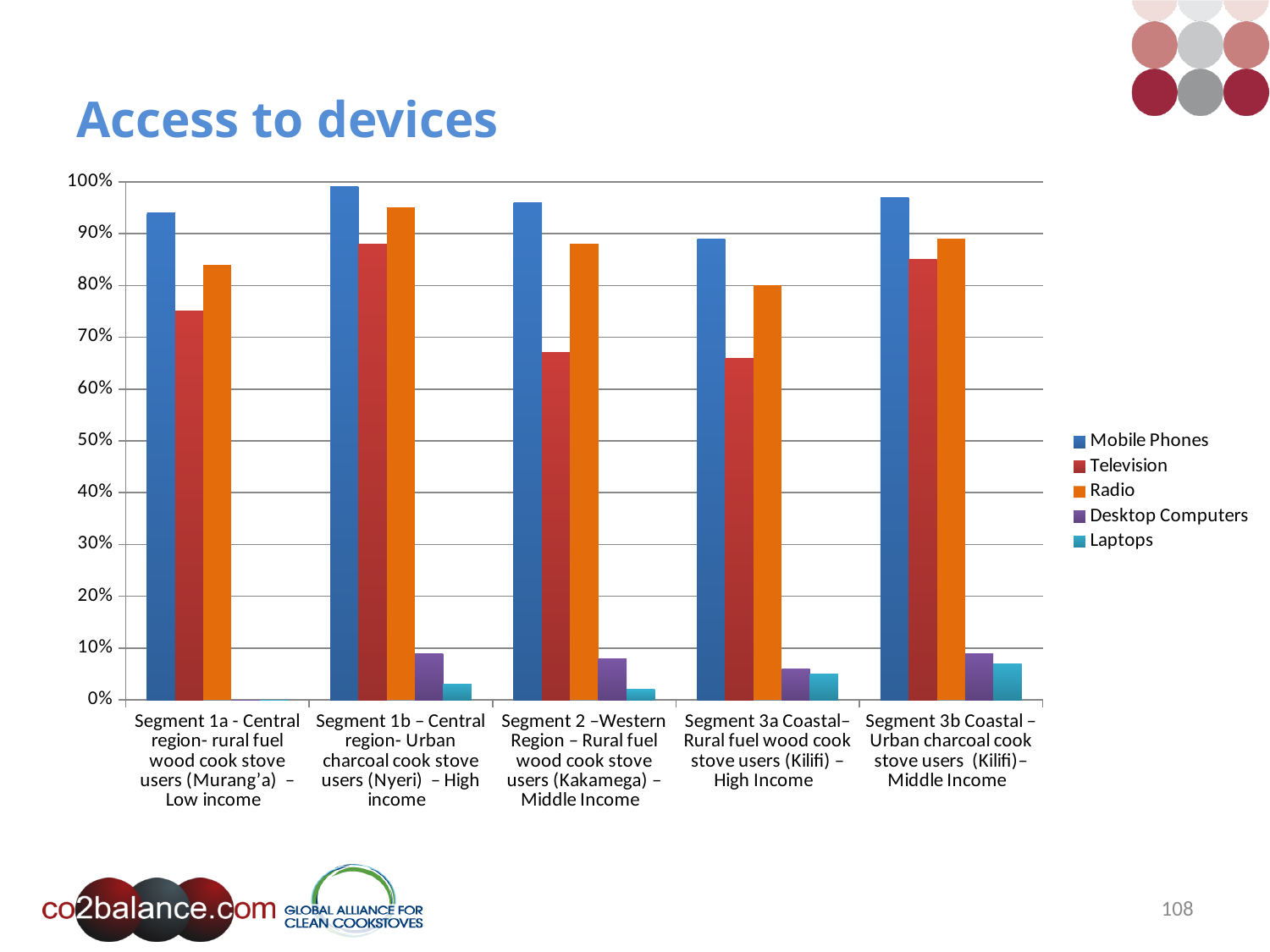
How many segments (categories) are shown along the x axis? 5 Which segment has the highest value for Mobile Phones? Segment 1b – Central region- Urban charcoal cook stove users (Nyeri) – High income In Segment 1b, which is larger: Desktop Computers or Laptops? Desktop Computers In Segment 3a, which is larger: Television or Radio? Radio What kind of chart is shown on the slide? bar chart What is the title of the chart? Access to devices Is the value for Laptops in Segment 3b greater or less than 10%? less Is the value for Television in Segment 1a greater or less than 70%? greater Which device has the highest access in every segment? Mobile Phones Is the value for Radio in Segment 2 greater or less than 90%? less How many series does the legend list? 5